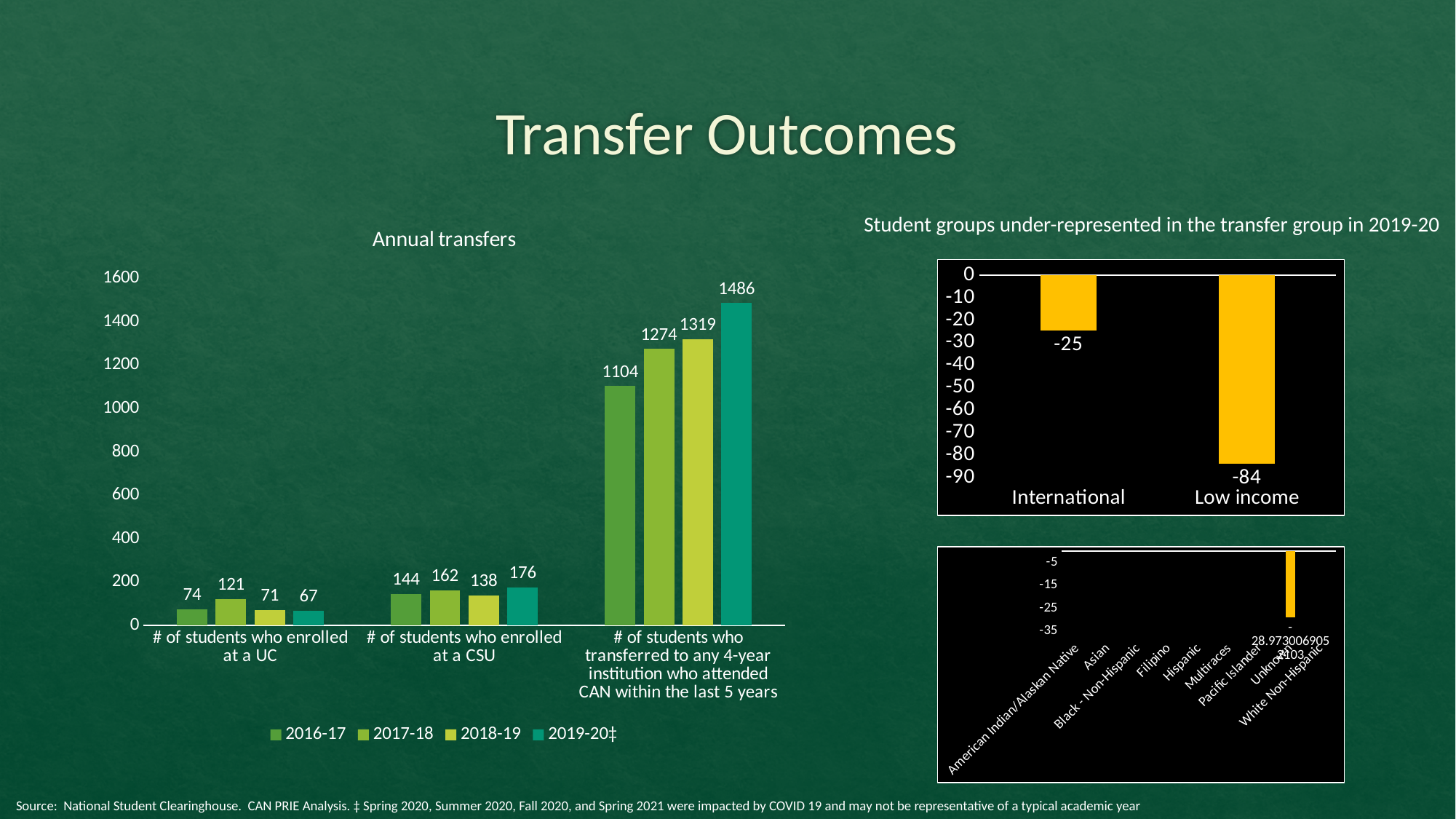
In the Student groups under-represented in the transfer group in 2019-20 chart, what is the value for International? -25 In the Annual transfers chart, which year has the lowest number of students who enrolled at a UC? 2019-20‡ In the Annual transfers chart, what is the difference between the 2019-20‡ and 2018-19 values for students who transferred to any 4-year institution? 167 What kind of chart is the Annual transfers chart? Bar chart In the Annual transfers chart, which year has the highest number of students who transferred to any 4-year institution? 2019-20‡ In the Student groups under-represented in the transfer group in 2019-20 chart, what is the difference between the International and Low income values? 59 In the Student groups under-represented in the transfer group in 2019-20 chart, what is the value for Low income? -84 In the Annual transfers chart, how many students enrolled at a UC in 2017-18? 121 In the Annual transfers chart, which is larger: the 2017-18 value for enrolled at a CSU or the 2018-19 value for enrolled at a CSU? 2017-18 In the Annual transfers chart, what is the 2019-20‡ value for # of students who enrolled at a CSU? 176 How many series does the legend of the Annual transfers chart list? 4 In the Annual transfers chart, what is the 2016-17 value for # of students who transferred to any 4-year institution who attended CAN within the last 5 years? 1104